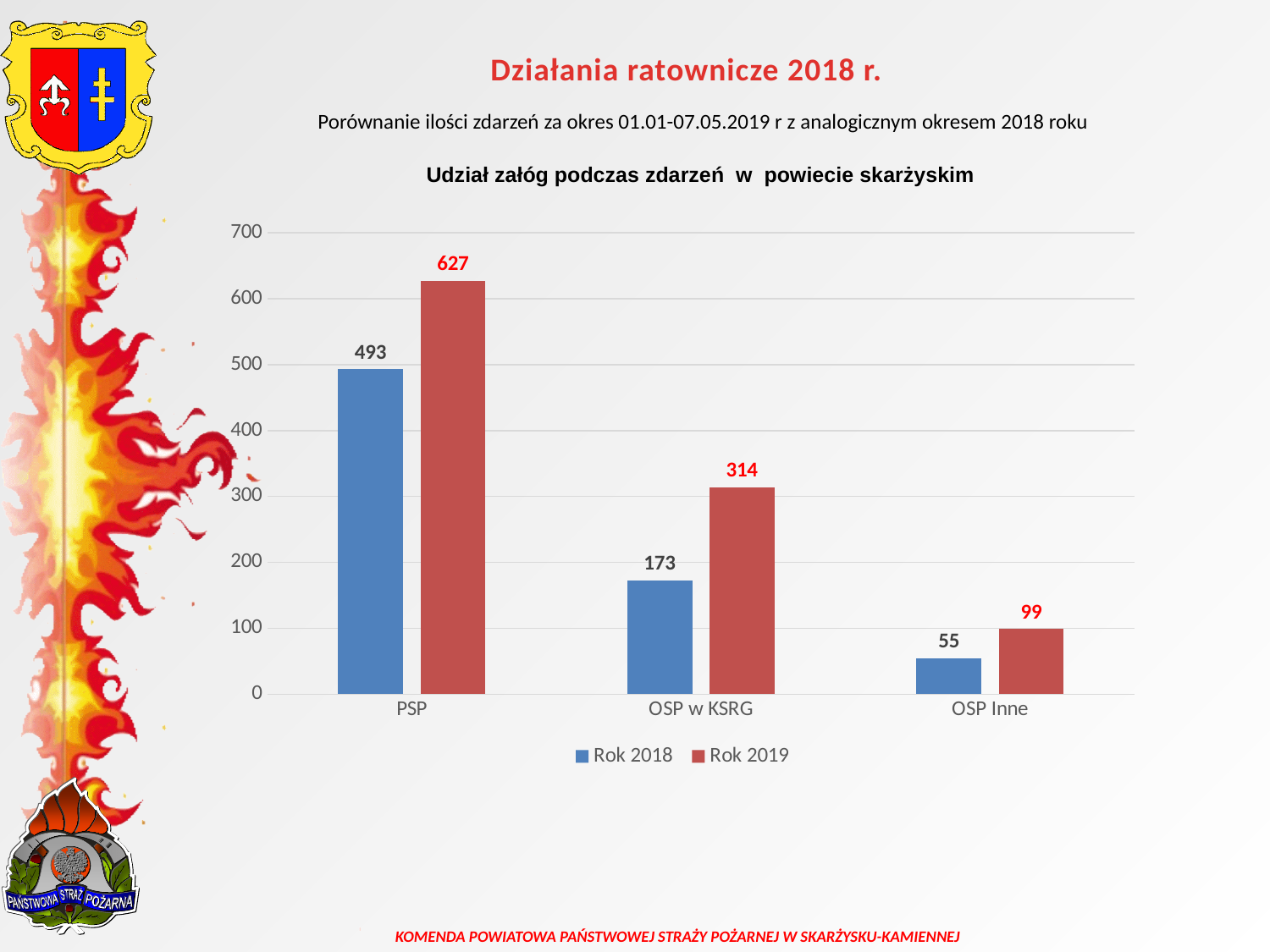
Which is larger: the Rok 2018 value for OSP w KSRG or the Rok 2019 value for OSP Inne? Rok 2018 value for OSP w KSRG Is the Rok 2019 value for OSP w KSRG greater or less than 300? greater How many series does the legend list? 2 What is the value for PSP in the Rok 2019 series? 627 Which category has the highest value in the Rok 2018 series? PSP How many categories are shown on the x axis? 3 Which category has the lowest value in the Rok 2019 series? OSP Inne What is the value for OSP w KSRG in the Rok 2018 series? 173 What is the value for OSP Inne in the Rok 2019 series? 99 What is the difference between the Rok 2019 and Rok 2018 values for OSP w KSRG? 141 What kind of chart is shown on the slide? bar chart What is the difference between the Rok 2019 and Rok 2018 values for PSP? 134